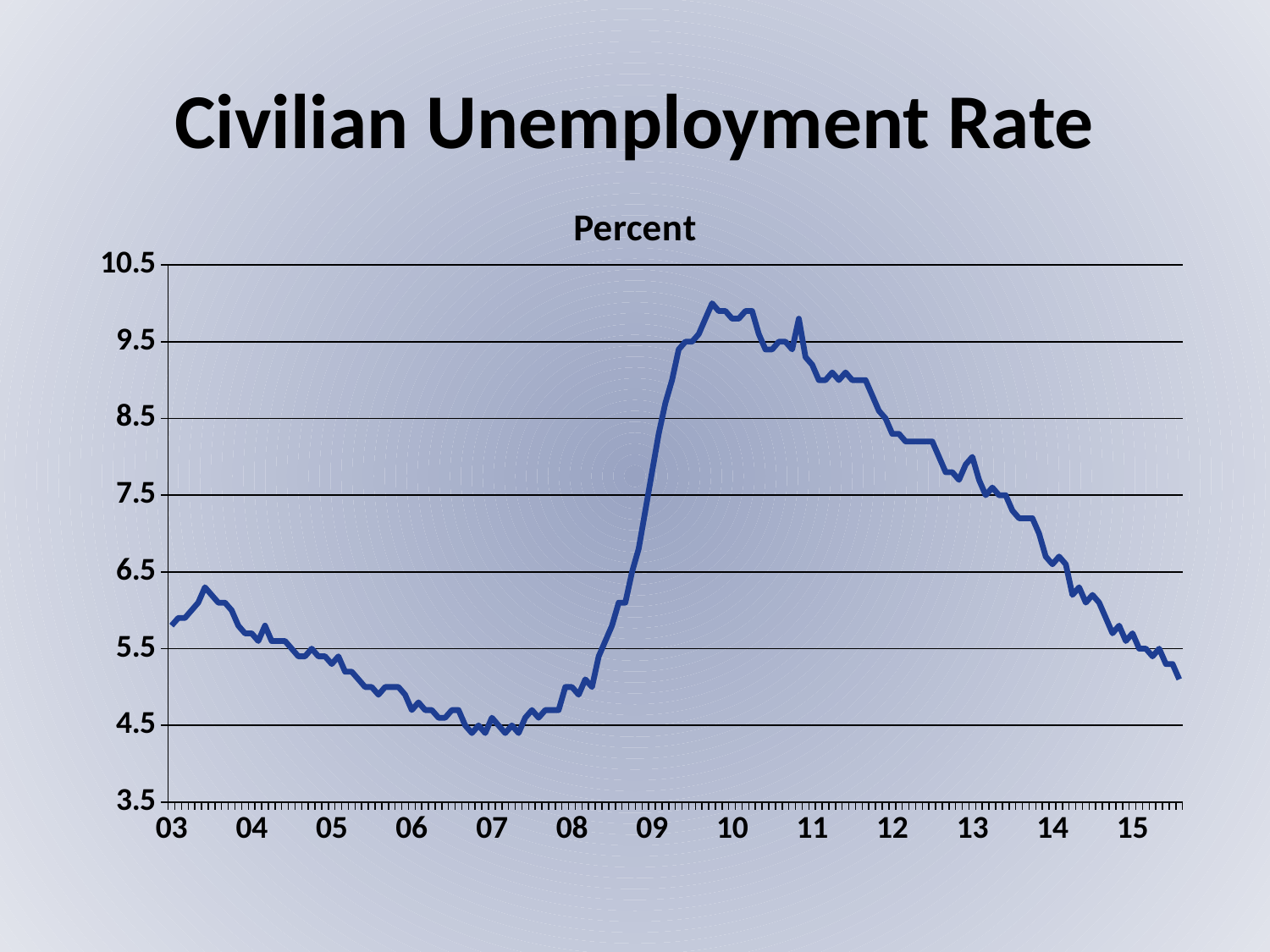
Is the value at the start of 03 greater or less than 5.5? greater Is the value at the 12 tick greater or less than 7.5? greater Does the unemployment rate rise or fall between the 11 tick and the 15 tick? fall Is the value at the 10 tick greater or less than 9.5? greater Does the unemployment rate rise or fall between the 09 tick and the 10 tick? rise How many lines are plotted on the chart? 1 What is the title of the chart? Civilian Unemployment Rate How many year labels are shown along the x axis? 13 What kind of chart is shown on the slide? line chart What unit label is shown above the chart's vertical axis? Percent